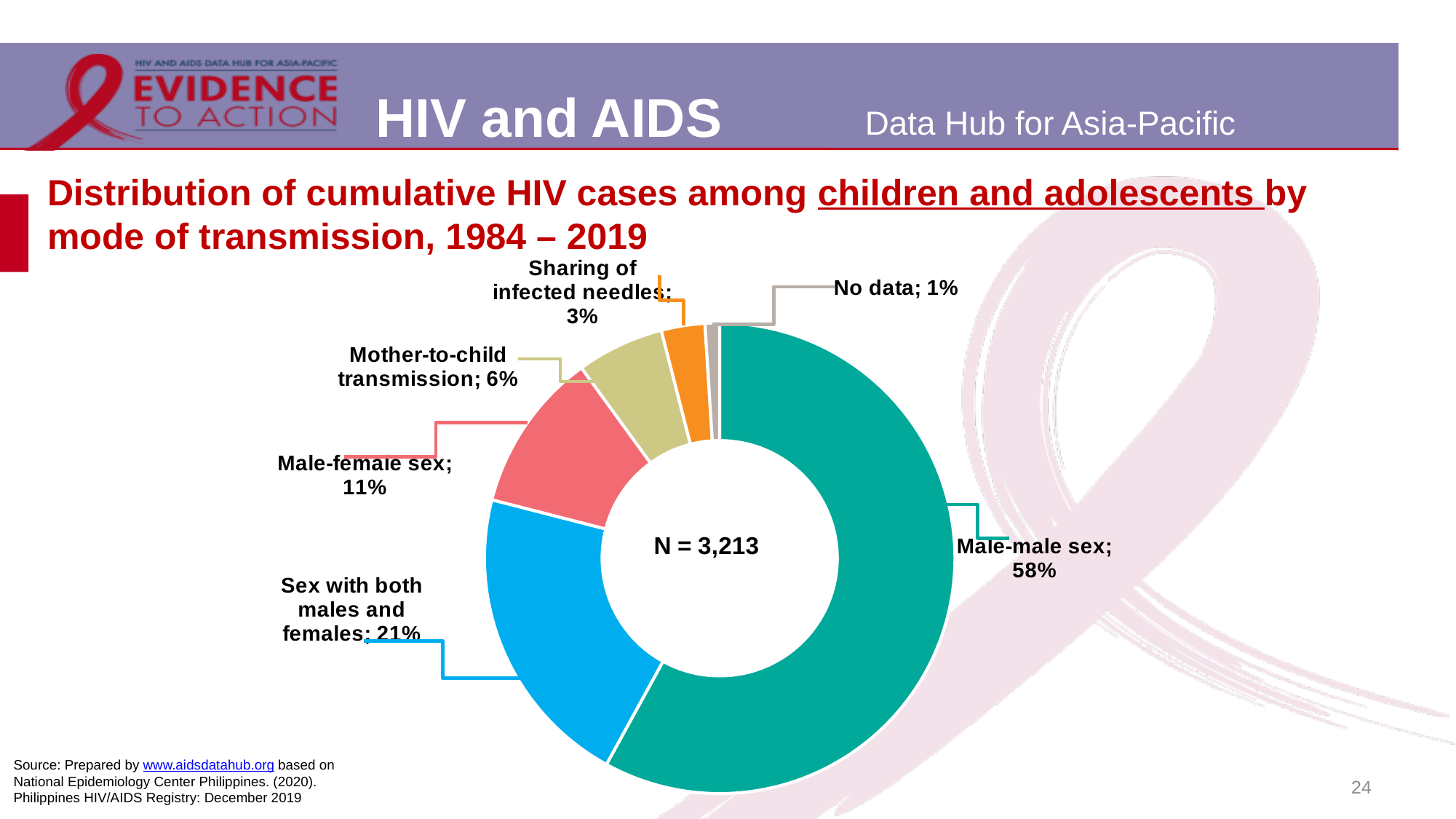
What percentage of cases is attributed to mother-to-child transmission? 6% What is the total number of cases (N) shown in the centre of the chart? 3,213 What is the difference in percentage points between male-male sex and sex with both males and females? 37 Which mode of transmission accounts for the largest share of cases? Male-male sex What percentage of cases is attributed to sex with both males and females? 21% Which category accounts for the smallest share of cases? No data Which is larger: the share for male-female sex or the share for mother-to-child transmission? Male-female sex How many categories are shown in the chart? 6 What kind of chart is shown on the slide? Pie chart (doughnut) What share of cumulative HIV cases among children and adolescents is attributed to male-male sex? 58% What percentage of cases is attributed to male-female sex? 11% What percentage of cases is attributed to sharing of infected needles? 3%